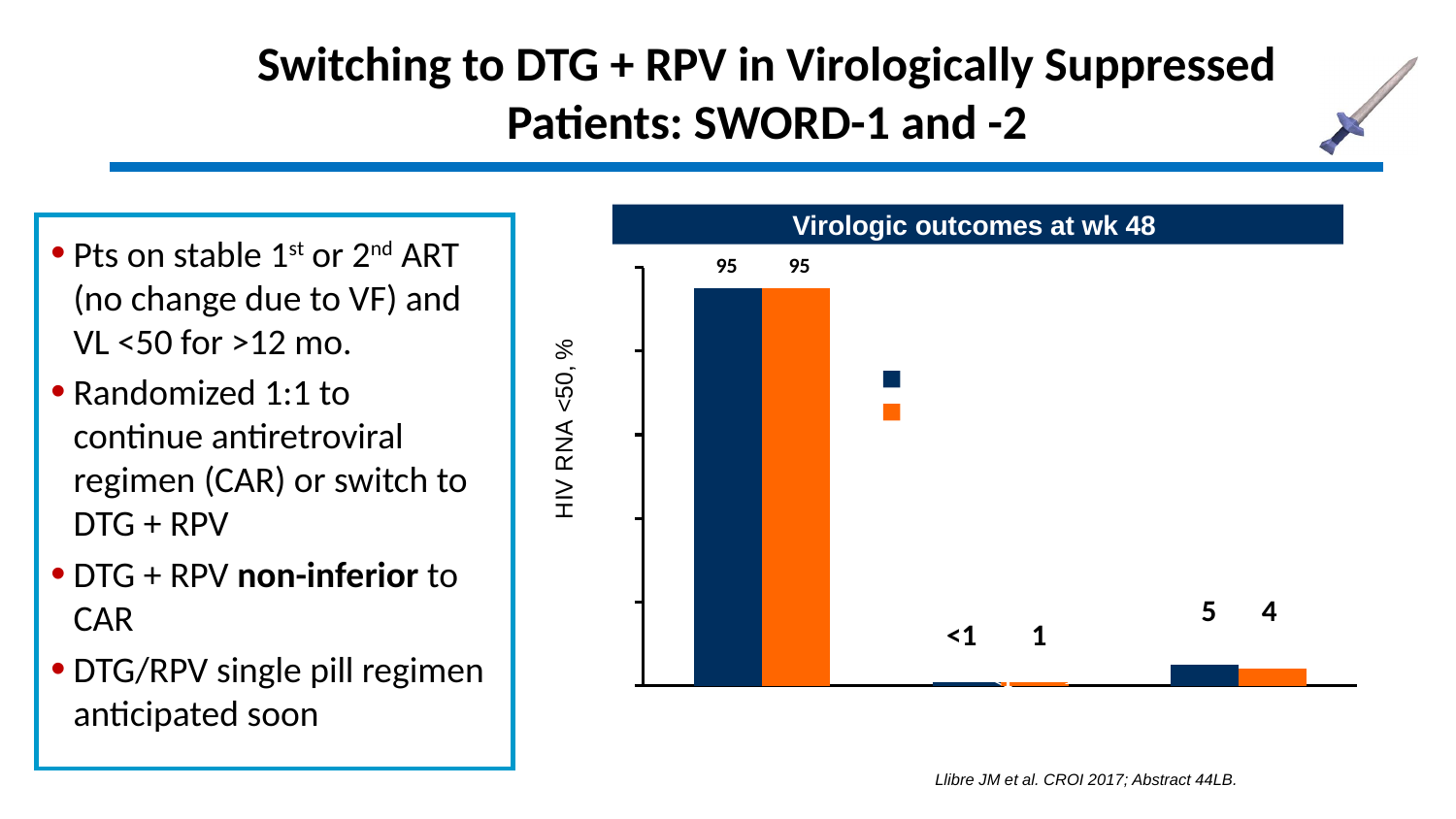
What is the value of the navy bar in the third (rightmost) group of bars? 5 How many series does the legend list? 2 What is the value of the orange bar in the middle group of bars? 1 What is the value of the navy bar in the first (leftmost) group of bars? 95 In the rightmost group of bars, what is the difference between the navy bar and the orange bar? 1 How many groups of bars are plotted in the chart? 3 What is the label on the y axis of the chart? HIV RNA <50, % What kind of chart is shown on the slide? bar chart What is the title of the chart? Virologic outcomes at wk 48 What is the value of the orange bar in the third (rightmost) group of bars? 4 What is the value of the navy bar in the middle group of bars? <1 What is the value of the orange bar in the first (leftmost) group of bars? 95